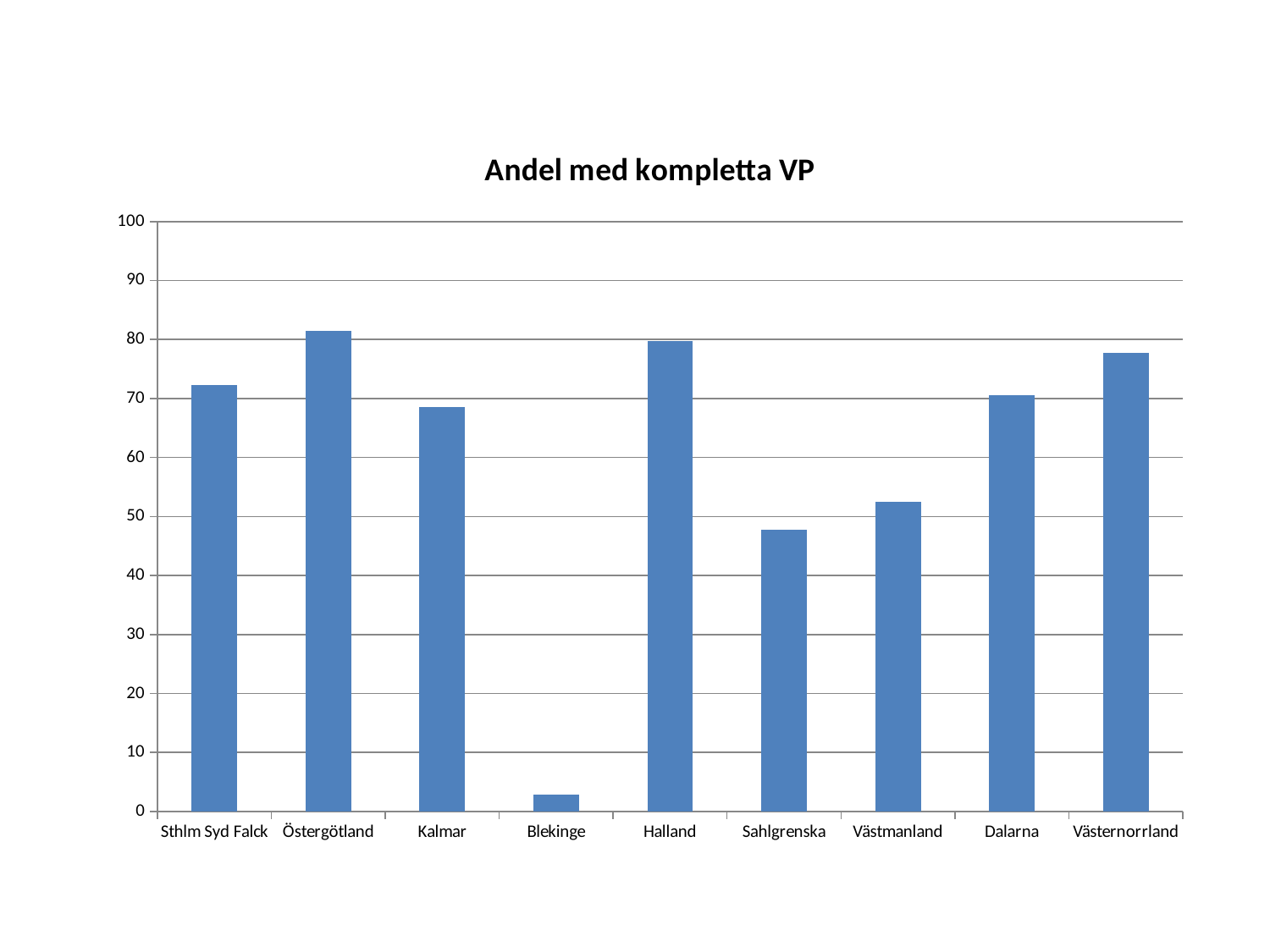
Is the value for Östergötland greater or less than 80? greater Which category has the lowest value? Blekinge Which is larger, the value for Sthlm Syd Falck or the value for Kalmar? Sthlm Syd Falck Is the value for Kalmar greater or less than 70? less What is the title of the chart? Andel med kompletta VP Is the value for Blekinge greater or less than 10? less How many categories are shown on the x axis? 9 Which is larger, the value for Dalarna or the value for Västernorrland? Västernorrland What type of chart is shown on the slide? bar chart